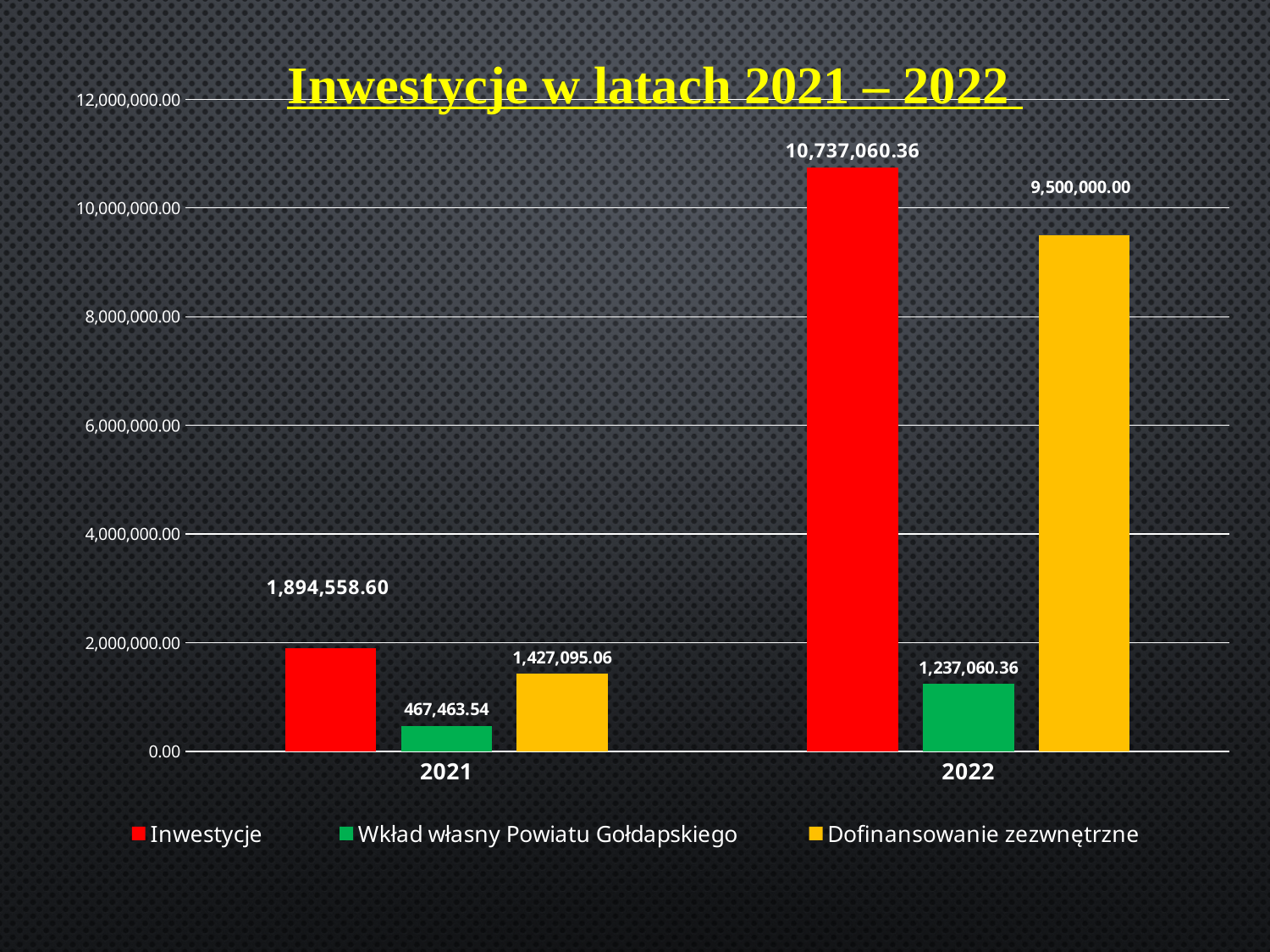
What kind of chart is shown on the slide? Bar chart What is the value of Wkład własny Powiatu Gołdapskiego for 2021? 467,463.54 What is the value of Inwestycje for 2021? 1,894,558.60 What is the difference between Inwestycje in 2022 and Inwestycje in 2021? 8,842,501.76 How many series does the legend list? 3 Which is larger in 2021: Dofinansowanie zezwnętrzne or Wkład własny Powiatu Gołdapskiego? Dofinansowanie zezwnętrzne Which series has the lowest value in 2021? Wkład własny Powiatu Gołdapskiego What is the value of Inwestycje for 2022? 10,737,060.36 What is the difference between Inwestycje and Dofinansowanie zezwnętrzne in 2022? 1,237,060.36 Which year has the higher value for Inwestycje? 2022 What is the value of Dofinansowanie zezwnętrzne for 2022? 9,500,000.00 What is the title of the chart? Inwestycje w latach 2021 – 2022